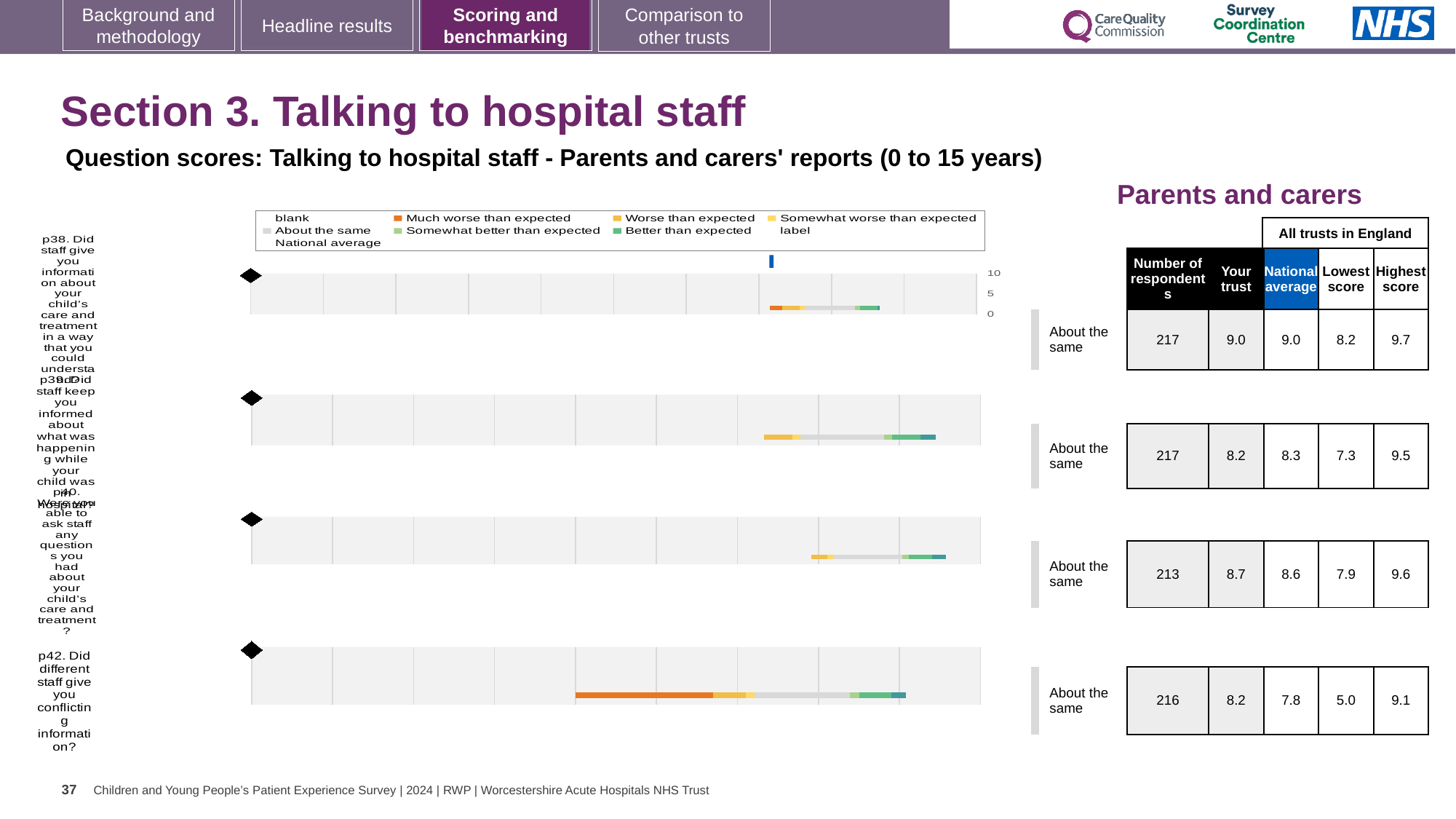
Which question has the highest 'Your trust' score in the table beside the charts? p38 What is the difference between the Highest score and the Lowest score for p42 in the table beside the charts? 4.1 In the table beside the charts, what is the 'Your trust' score for p38 (Did staff give you information about your child's care and treatment in a way that you could understand)? 9.0 In the table beside the charts, what is the National average for p42 (Did different staff give you conflicting information)? 7.8 What kind of chart is used to show the question scores on this slide? bar chart How many entries does the chart legend list? 9 For p40, which is larger in the table beside the charts: the 'Your trust' score or the National average? Your trust In the chart legend, what colour represents 'Much worse than expected'? orange What benchmark category is shown next to each of the four charts? About the same How many question charts (rows) are shown on the slide? 4 Which question has the lowest 'Lowest score' value in the table beside the charts? p42 In the table beside the charts, how many respondents are listed for p40 (Were you able to ask staff any questions you had about your child's care and treatment)? 213